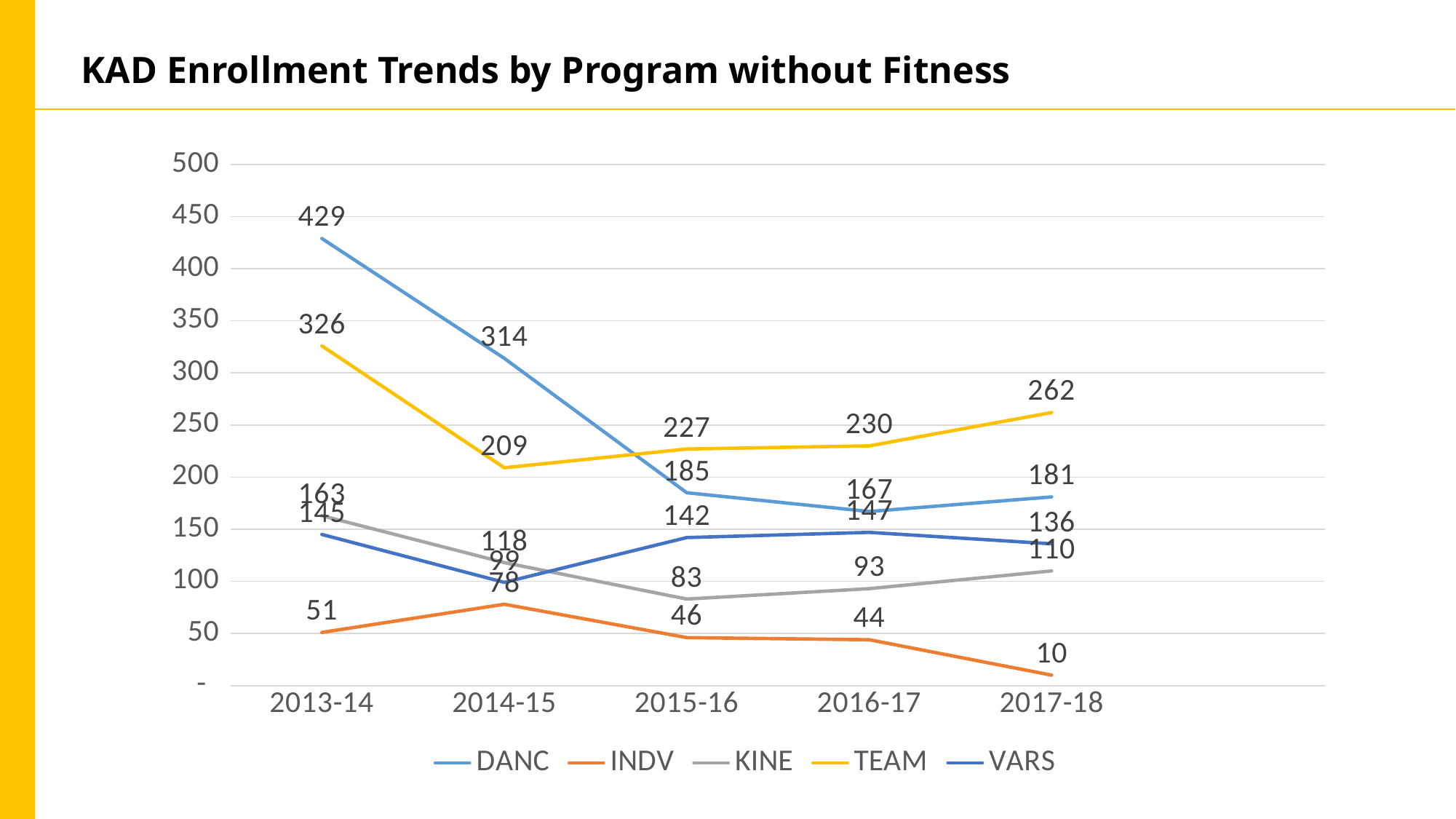
In which year is the DANC series at its highest? 2013-14 What is the INDV enrollment value for 2017-18? 10 Does the DANC series rise or fall from 2013-14 to 2015-16? Fall In which year is the INDV series at its lowest? 2017-18 How many academic years are shown on the x axis? 5 In 2015-16, which series has the larger value, TEAM or DANC? TEAM What is the TEAM enrollment value for 2017-18? 262 What is the difference between the DANC values for 2013-14 and 2014-15? 115 How many series does the legend list? 5 What is the DANC enrollment value for 2013-14? 429 What is the title of the chart? KAD Enrollment Trends by Program without Fitness What type of chart is shown on the slide? Line chart